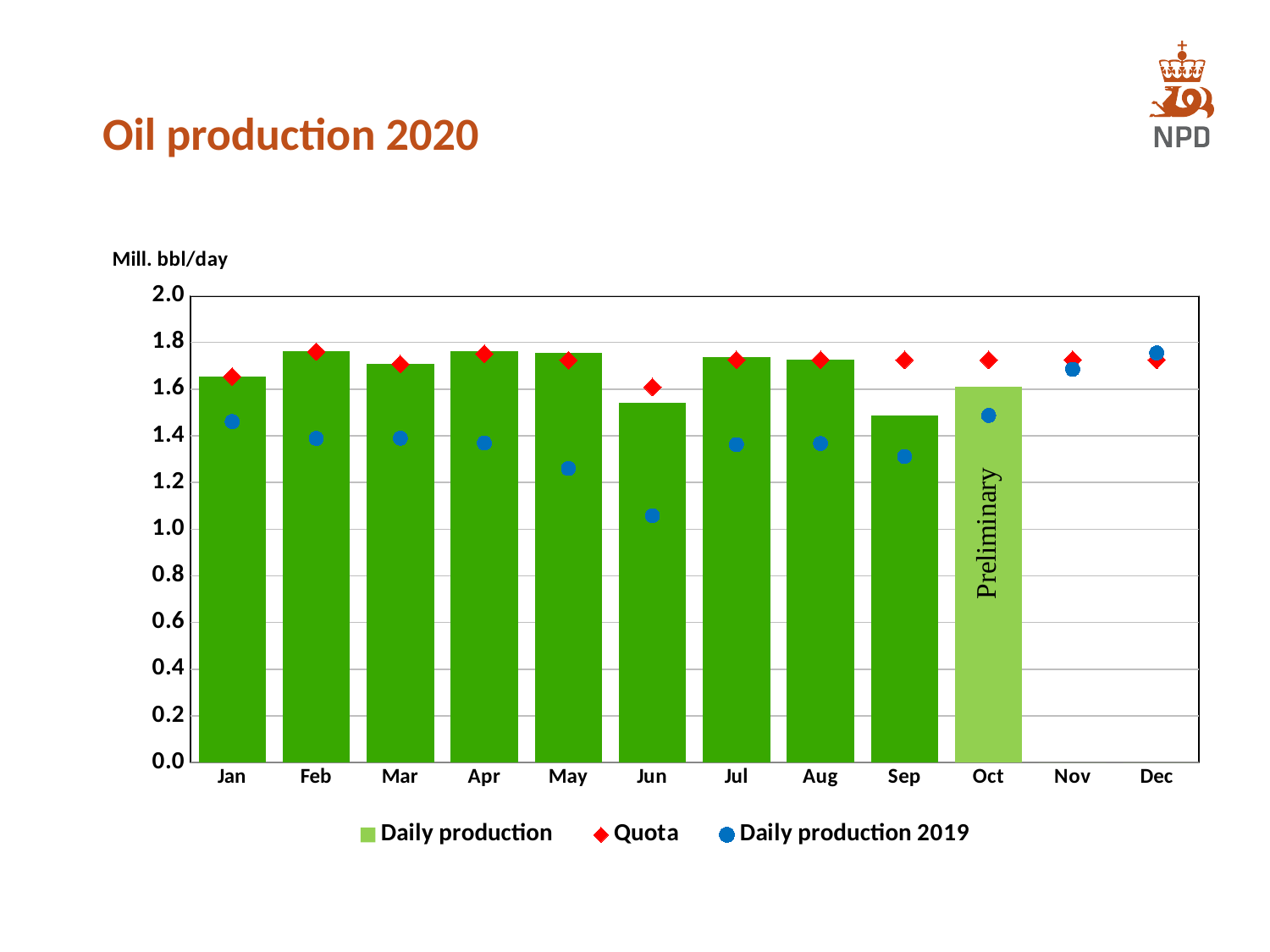
How many months have a Daily production bar plotted? 10 Which month has the highest Daily production 2019 value? Dec Is the Daily production value for Feb greater or less than 1.6? greater Which month has the lowest Daily production 2019 value? Jun Which month's bar is marked as Preliminary? Oct Is the Daily production 2019 value for Jun greater or less than 1.2? less In Jan, which is larger: Daily production or Daily production 2019? Daily production In Jun, which is larger: the Daily production bar or the Quota? Quota What kind of chart is shown on the slide? Combination bar and line chart (bars with point markers) Which month has the lowest Daily production bar? Sep Is the Daily production value for Jun greater or less than 1.6? less How many series does the legend list? 3